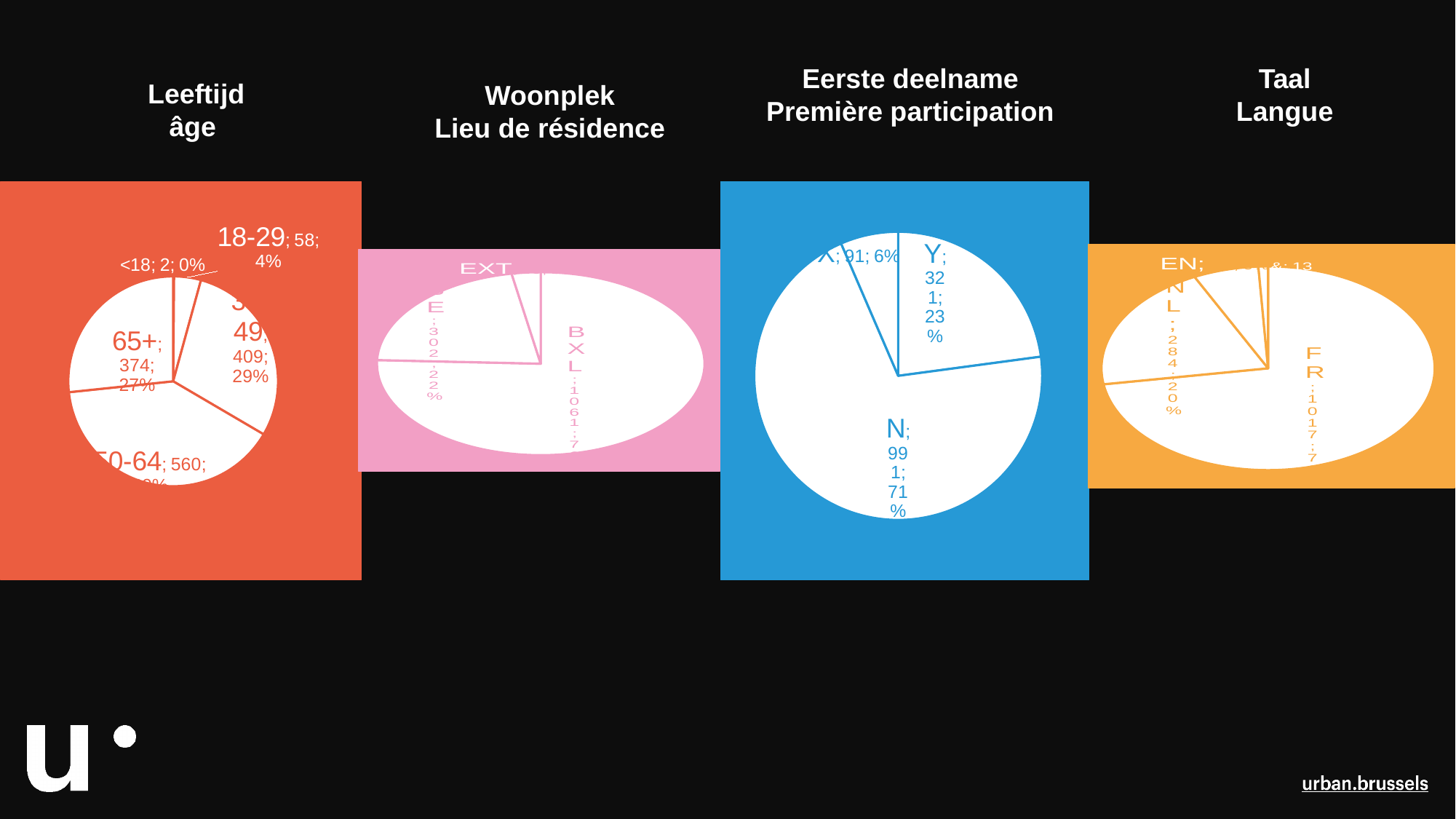
How many pie charts are shown on the slide? 4 In the 'Taal / Langue' chart, what share of the pie is NL? 20% In the 'Leeftijd / âge' chart, what is the value for 18-29? 58 In the 'Leeftijd / âge' chart, what is the value for 65+? 374 In the 'Eerste deelname / Première participation' chart, what is the value for N? 991 In the 'Eerste deelname / Première participation' chart, which is larger, Y or N? N In the 'Eerste deelname / Première participation' chart, which category has the largest slice? N In the 'Eerste deelname / Première participation' chart, what share of the pie is Y? 23% In the 'Leeftijd / âge' chart, what is the difference between the values for 65+ and 18-29? 316 In the 'Leeftijd / âge' chart, what share of the pie is 65+? 27% What kind of chart is used in the 'Eerste deelname / Première participation' panel? pie chart